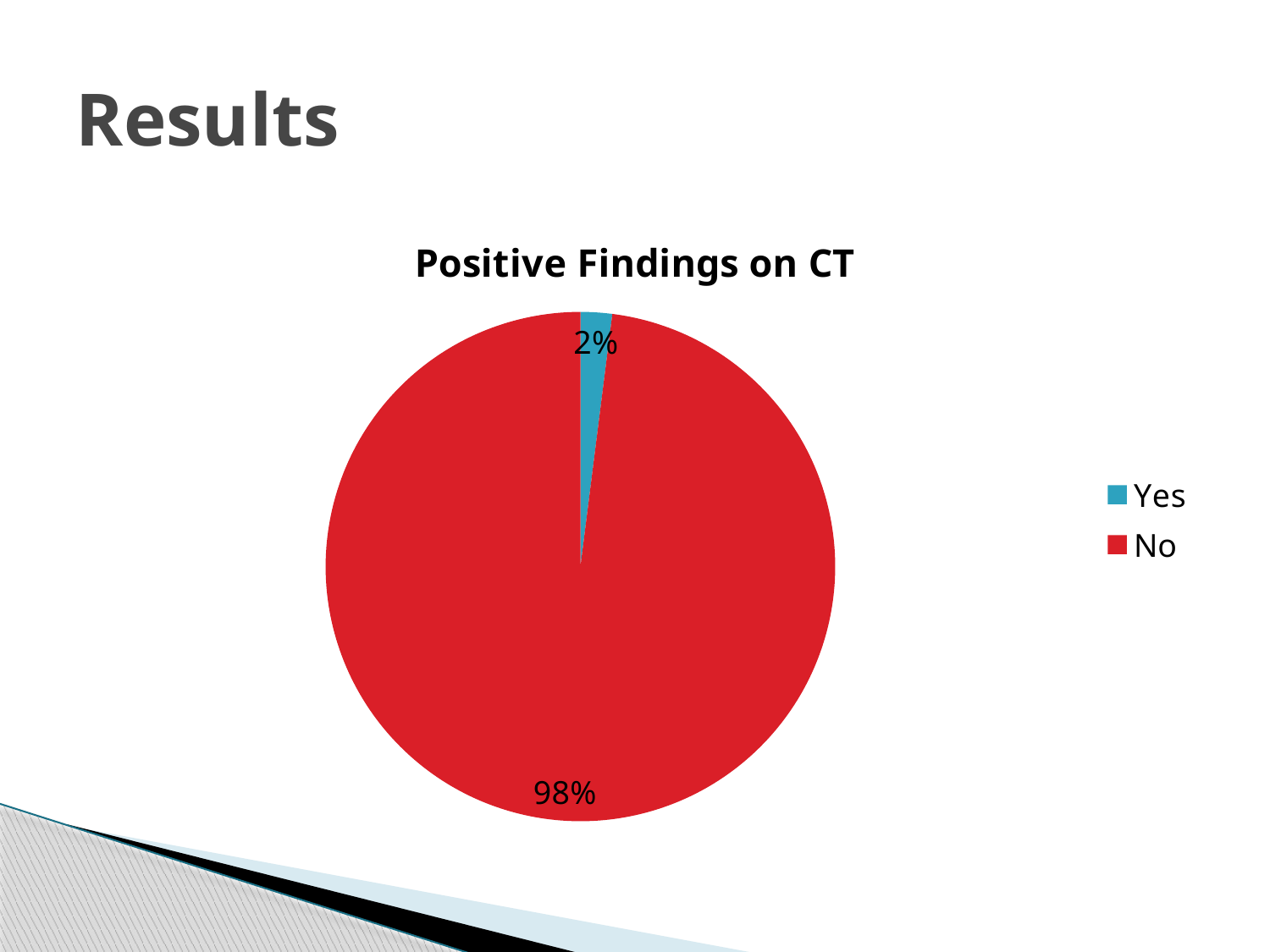
What type of chart is shown on the slide? pie chart Which category has the smallest share of the pie? Yes What percentage of the pie is labelled "No"? 98% Which category has the largest share of the pie? No What is the title of the chart? Positive Findings on CT What share of the pie does the "No" slice represent? 98% Which slice is larger, "Yes" or "No"? No How many slices does the pie chart have? 2 What is the difference in percentage points between the "No" and "Yes" slices? 96 What colour is the "Yes" slice? blue What percentage of the pie is labelled "Yes"? 2% How many entries does the legend list? 2